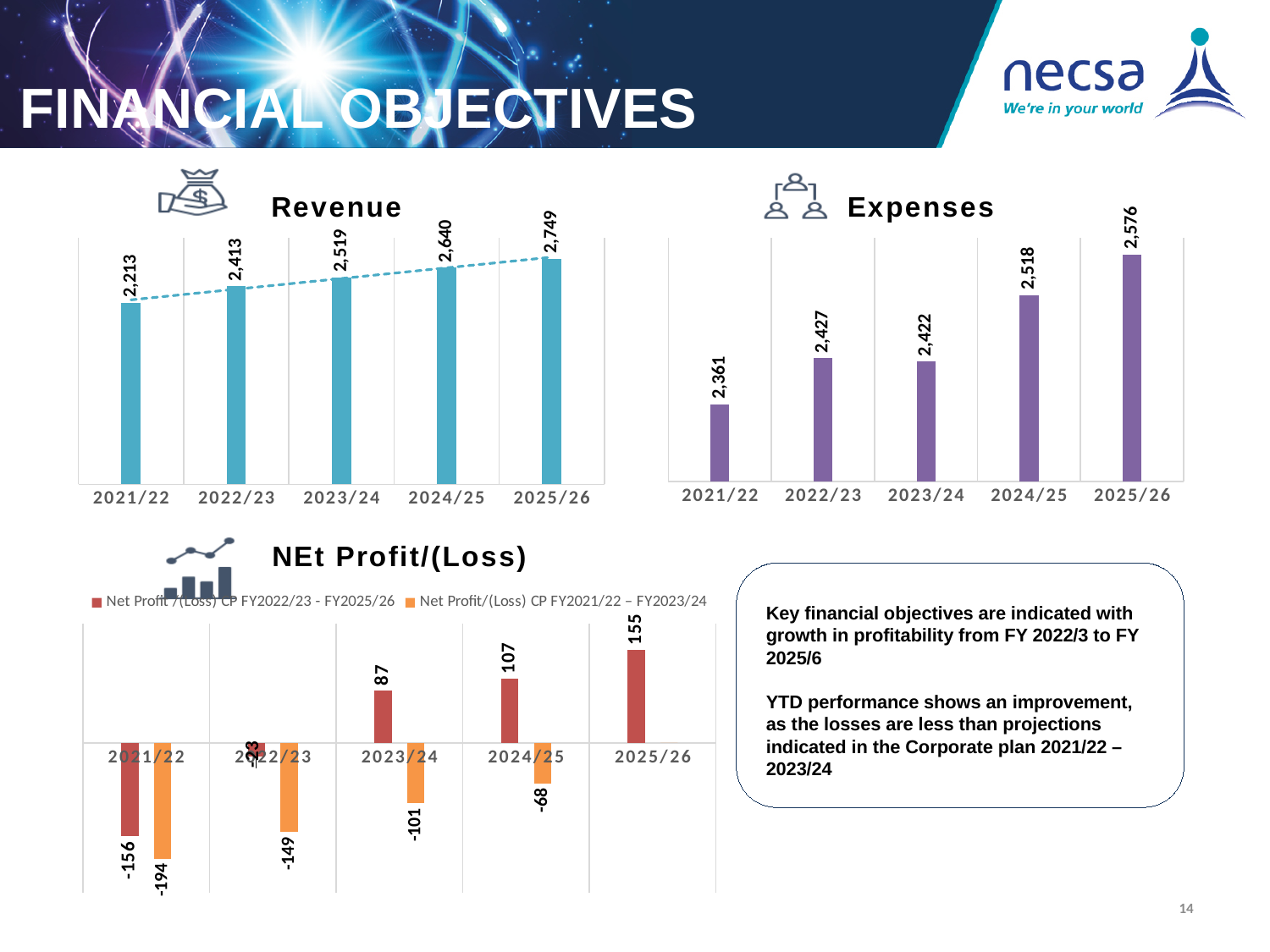
In the NEt Profit/(Loss) chart, what is the value for 2025/26 in the Net Profit/(Loss) CP FY2022/23 - FY2025/26 series? 155 In the Expenses chart, which year has the lowest expenses? 2021/22 In the Revenue chart, which year has the highest revenue? 2025/26 In the NEt Profit/(Loss) chart, how many series does the legend list? 2 In the Revenue chart, what is the difference between the 2025/26 and 2021/22 values? 536 In the Expenses chart, what is the expenses value for 2024/25? 2,518 In the Expenses chart, what is the difference between the 2022/23 and 2023/24 values? 5 In the Revenue chart, do the values rise or fall from 2021/22 to 2025/26? rise What kind of chart is the Expenses chart? bar chart In the Expenses chart, how many years are shown on the x axis? 5 In the NEt Profit/(Loss) chart, what is the value for 2021/22 in the Net Profit/(Loss) CP FY2021/22 – FY2023/24 series? -194 In the Revenue chart, what is the revenue value for 2023/24? 2,519